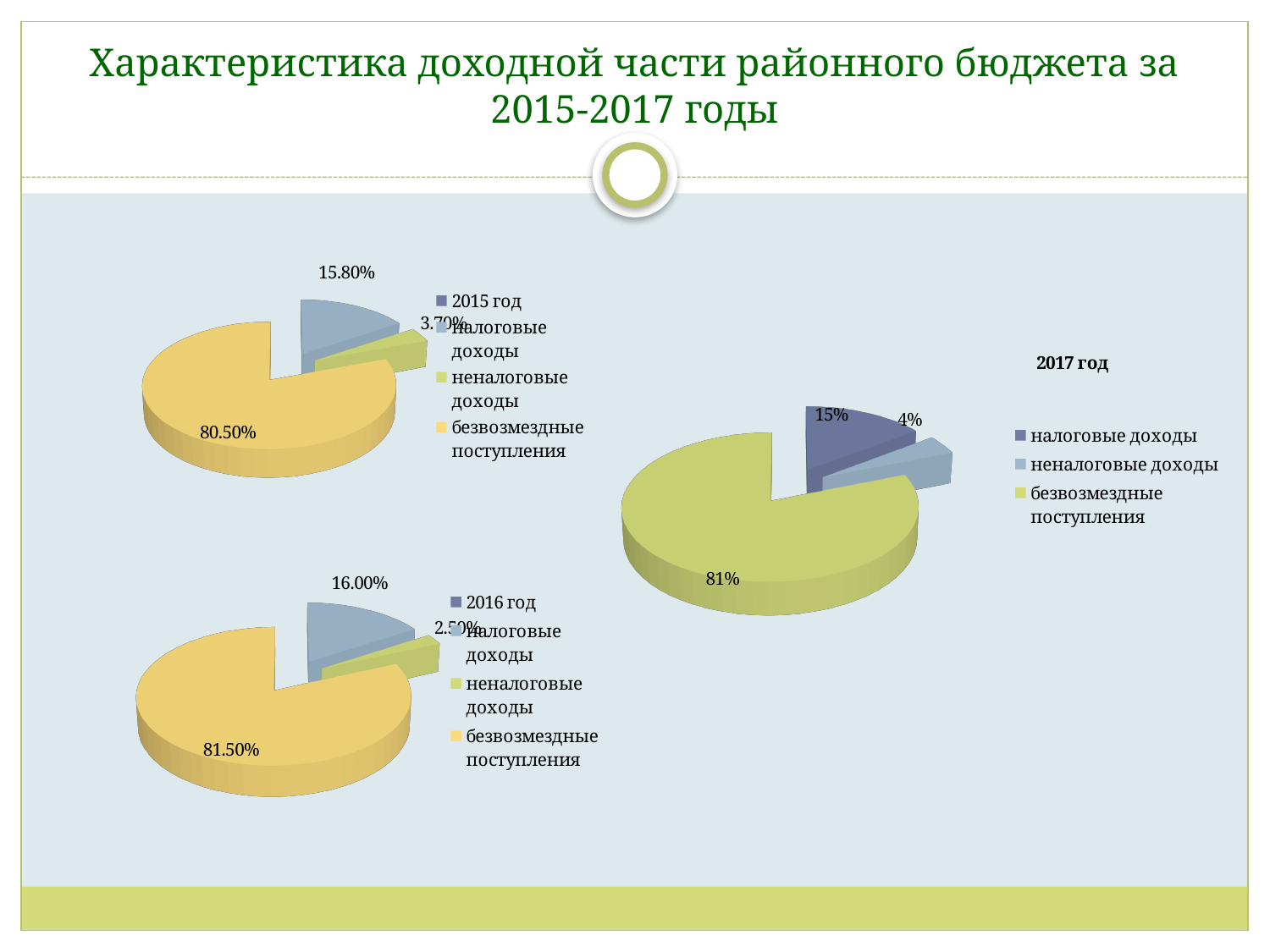
In the 2016 год pie chart, what share is shown for безвозмездные поступления? 81.50% In the 2017 год pie chart, which category has the largest slice? безвозмездные поступления In the 2015 год pie chart, which is larger: налоговые доходы or неналоговые доходы? налоговые доходы What type of chart is used to show the 2017 год data? pie chart In the 2017 год pie chart, what share is shown for неналоговые доходы? 4% In the 2017 год pie chart, what share is shown for безвозмездные поступления? 81% In the 2015 год pie chart, what share is shown for безвозмездные поступления? 80.50% How many categories does the legend of the 2017 год chart list? 3 In the 2017 год pie chart, what is the difference between the shares of налоговые доходы and неналоговые доходы? 11% In the 2016 год pie chart, which category has the smallest slice? неналоговые доходы In the 2015 год pie chart, what share is shown for налоговые доходы? 15.80% In the 2016 год pie chart, what share is shown for налоговые доходы? 16.00%